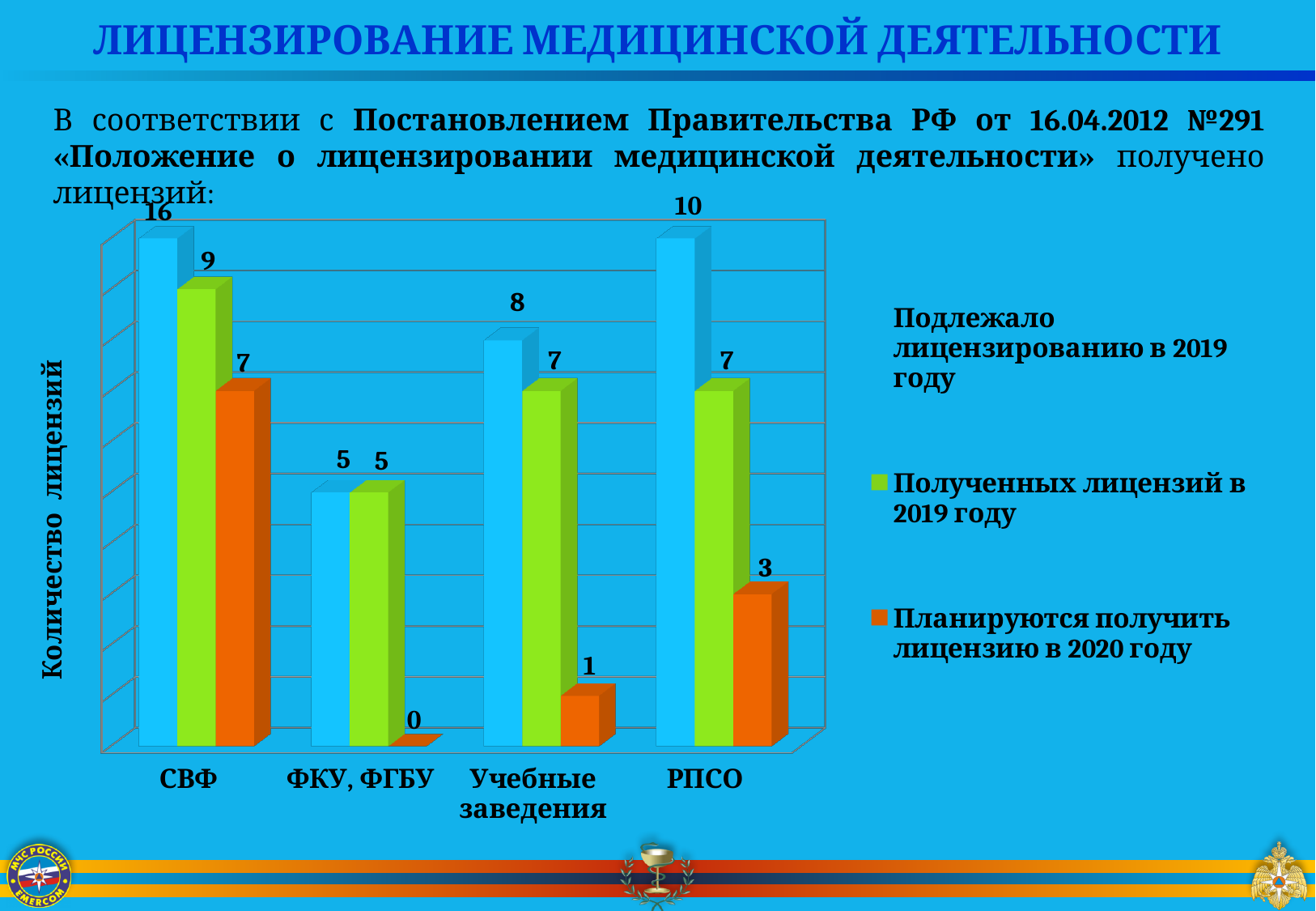
Which is larger for РПСО: «Подлежало лицензированию в 2019 году» or «Планируются получить лицензию в 2020 году»? Подлежало лицензированию в 2019 году What is the value of «Планируются получить лицензию в 2020 году» for Учебные заведения? 1 What is the value of «Подлежало лицензированию в 2019 году» for СВФ? 16 What is the value of «Полученных лицензий в 2019 году» for РПСО? 7 What is the value of «Планируются получить лицензию в 2020 году» for ФКУ, ФГБУ? 0 How many series does the chart legend list? 3 Which category has the lowest value for «Планируются получить лицензию в 2020 году»? ФКУ, ФГБУ What is the label of the vertical axis of the chart? Количество лицензий What kind of chart is shown on the slide? Bar chart Which category has the highest value for «Подлежало лицензированию в 2019 году»? СВФ What is the difference between «Подлежало лицензированию в 2019 году» and «Полученных лицензий в 2019 году» for СВФ? 7 How many categories are shown on the x axis of the chart? 4